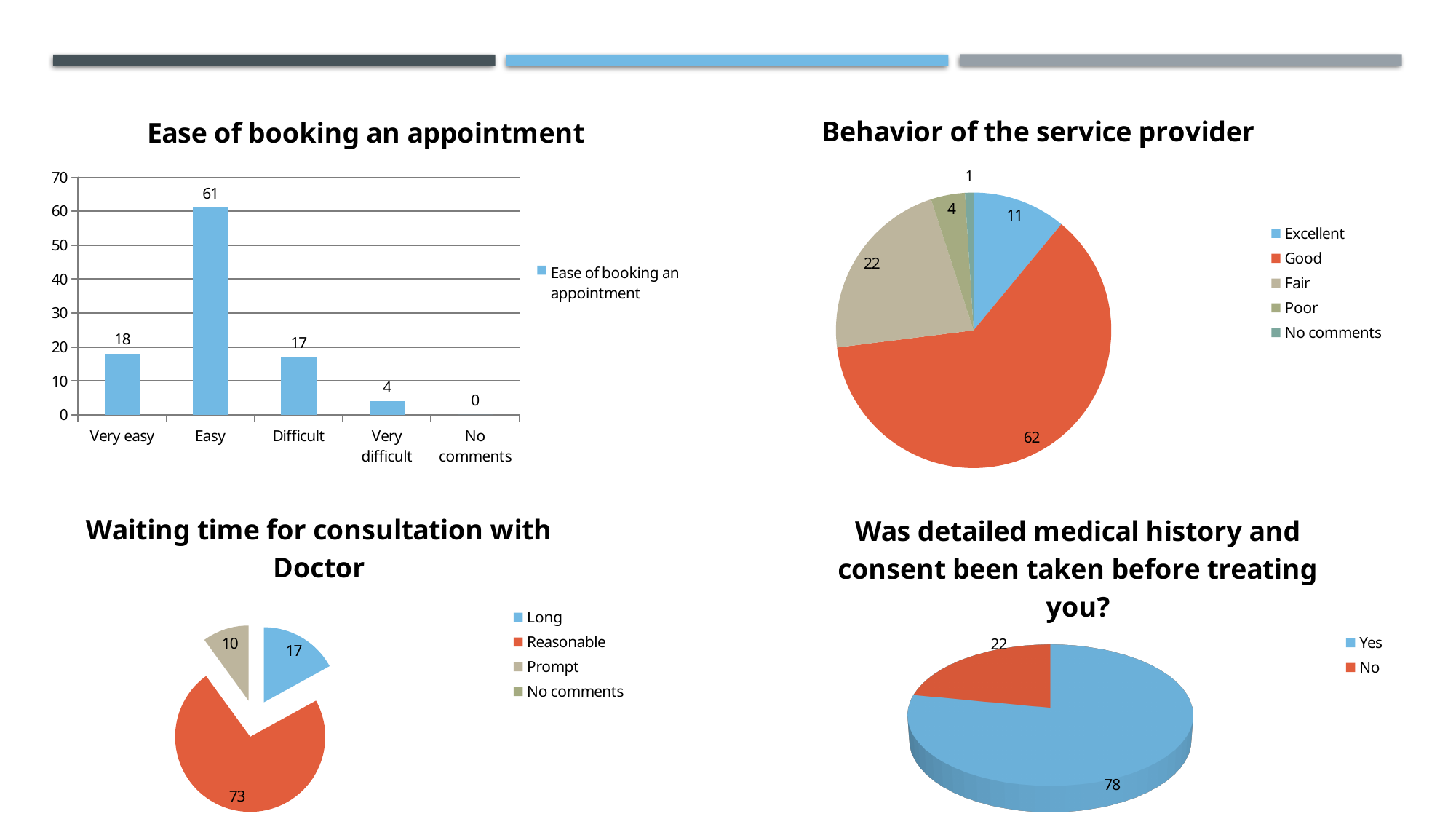
In the 'Was detailed medical history and consent been taken before treating you?' chart, what is the value for No? 22 In the 'Waiting time for consultation with Doctor' chart, how many entries does the legend list? 4 In the 'Behavior of the service provider' chart, which category has the largest slice? Good In the 'Waiting time for consultation with Doctor' chart, what is the value for Prompt? 10 In the 'Ease of booking an appointment' chart, how many categories are shown on the x axis? 5 In the 'Was detailed medical history and consent been taken before treating you?' chart, which is larger, Yes or No? Yes What kind of chart is 'Ease of booking an appointment'? Bar chart In the 'Ease of booking an appointment' chart, what is the value for Easy? 61 In the 'Ease of booking an appointment' chart, which category has the lowest value? No comments In the 'Behavior of the service provider' chart, what is the value for Fair? 22 In the 'Ease of booking an appointment' chart, what is the difference between Very easy and Difficult? 1 In the 'Behavior of the service provider' chart, what is the total of all slices? 100